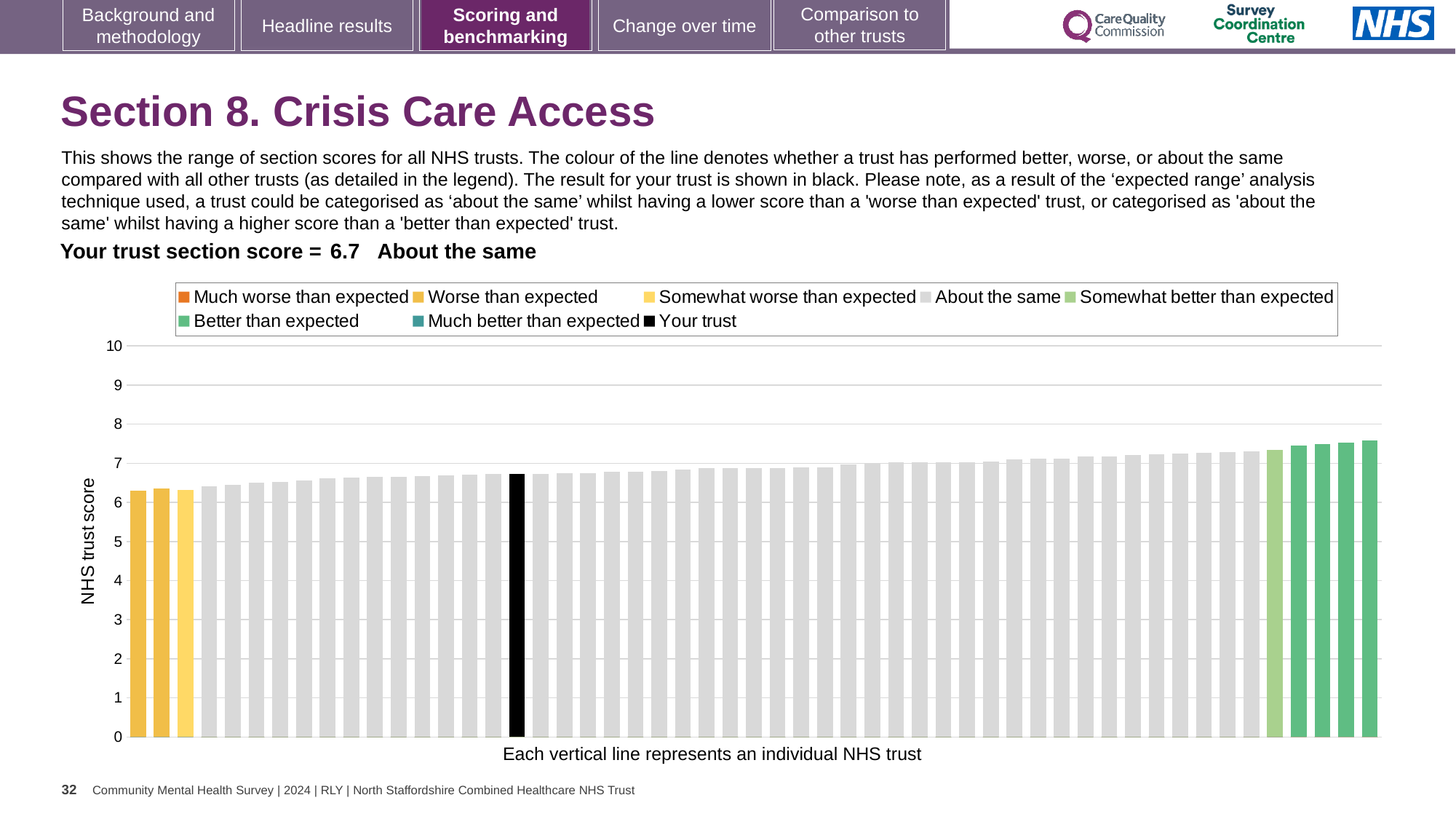
How many bars are coloured as 'Worse than expected'? 2 What kind of chart is shown on the slide? bar chart Which legend category do the shortest bars belong to? Worse than expected What is the section score for your trust? 6.7 Do the bar values rise or fall from left to right along the x axis? rise How many entries does the chart legend list? 8 Is the value of the shortest bar greater or less than 7? less What is the label on the vertical axis? NHS trust score What colour is the bar representing your trust? black Is the value of the tallest bar greater or less than 7? greater Which legend category do the tallest bars belong to? Better than expected Is the value for your trust greater or less than 5? greater